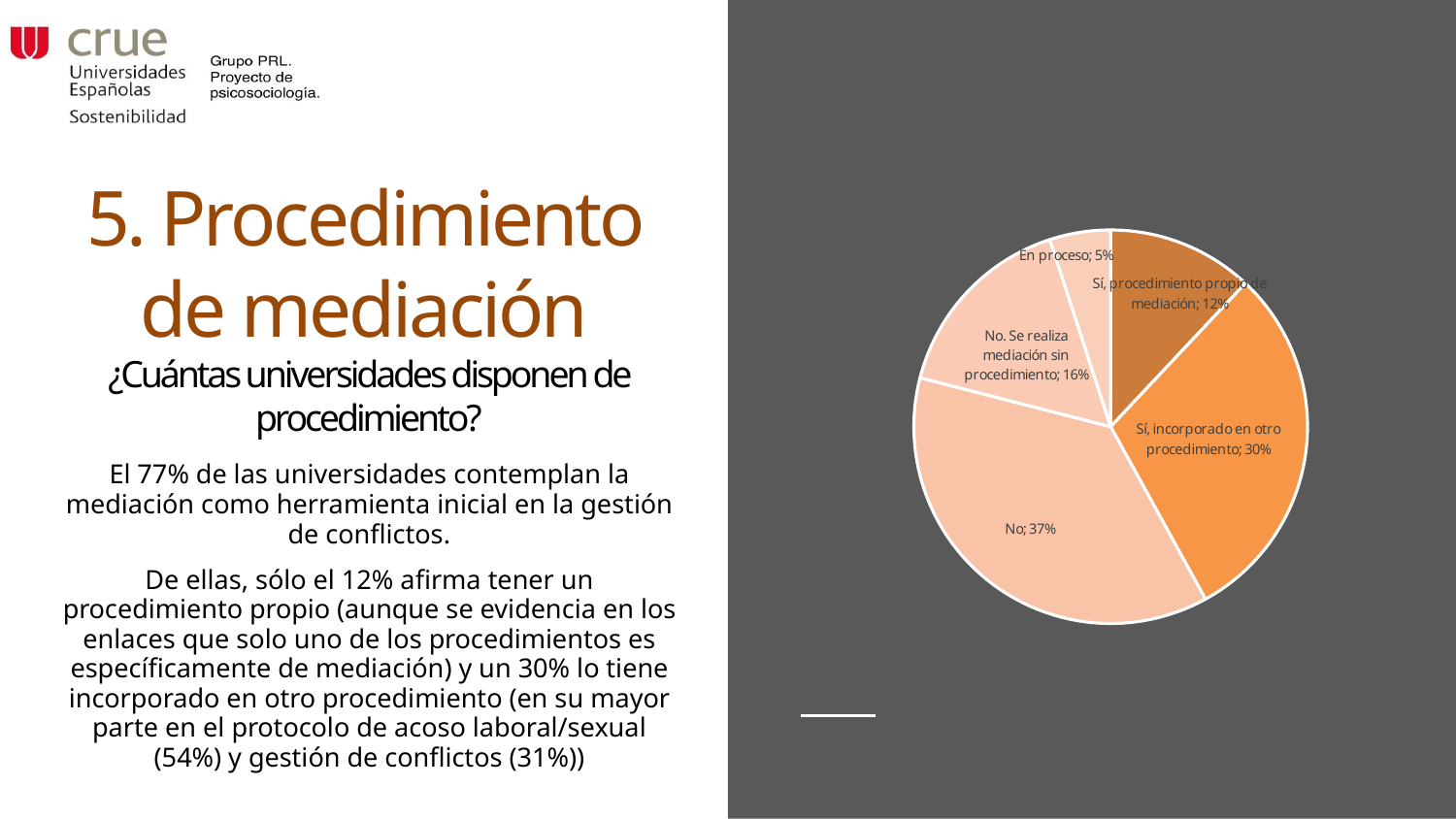
Which slice of the pie chart is the smallest? En proceso What percentage is shown for "Sí, incorporado en otro procedimiento"? 30% How many slices does the pie chart have? 5 What percentage is shown for "Sí, procedimiento propio de mediación"? 12% What is the combined share of the two "Sí" slices in the pie chart? 42% Which slice of the pie chart is the largest? No What percentage is shown for the slice "En proceso"? 5% Which is larger: "No. Se realiza mediación sin procedimiento" or "Sí, procedimiento propio de mediación"? No. Se realiza mediación sin procedimiento What percentage is shown for the slice "No"? 37% What kind of chart is shown on the slide? Pie chart What percentage is shown for "No. Se realiza mediación sin procedimiento"? 16% What is the difference in percentage points between "No" and "Sí, incorporado en otro procedimiento"? 7